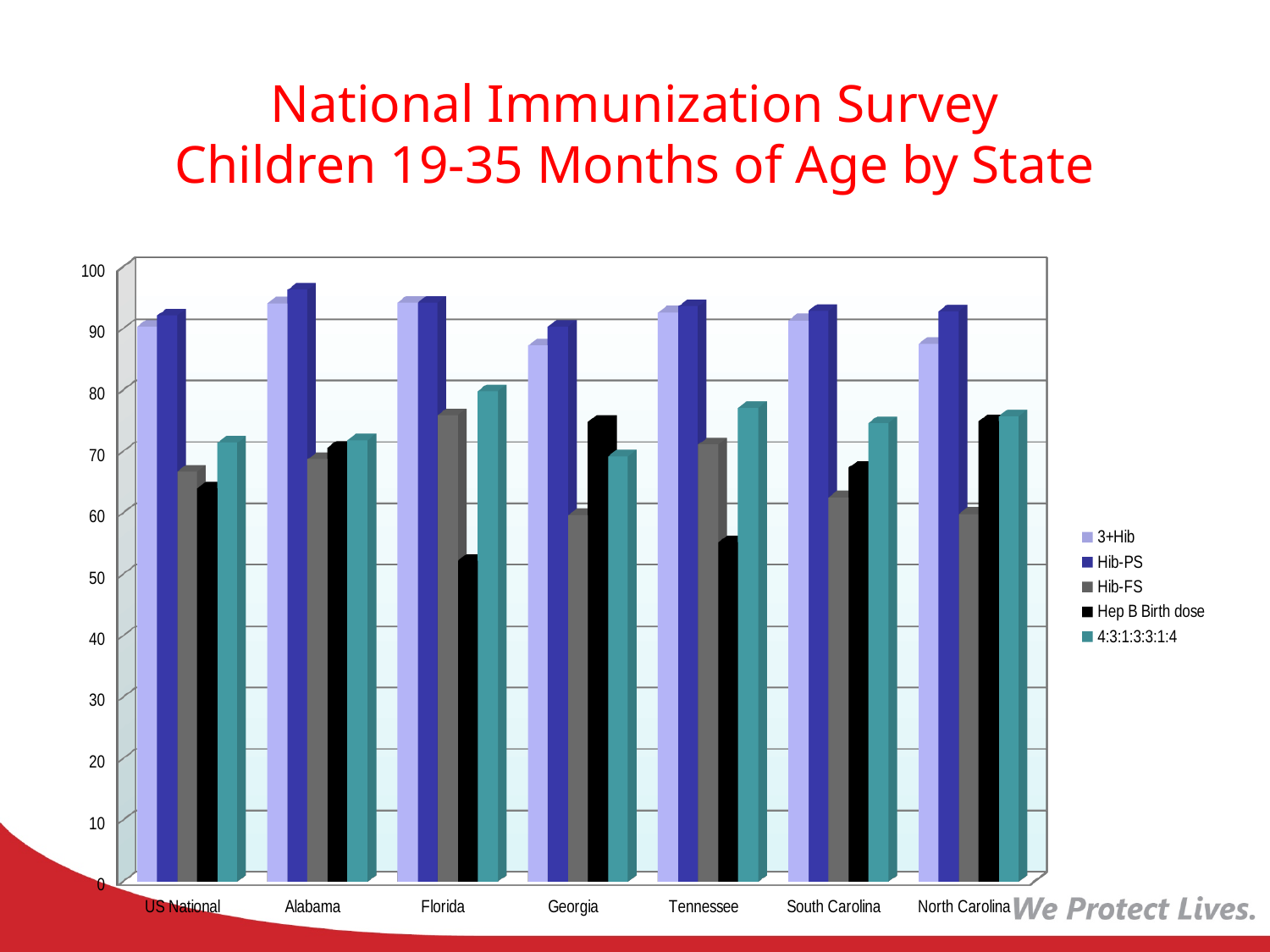
How many states or categories are shown along the x axis? 7 What kind of chart is shown on the slide? bar chart Is the Hib-PS value for Alabama greater or less than 90? greater What is the title of the slide containing the chart? National Immunization Survey Children 19-35 Months of Age by State Is the Hep B Birth dose value for Florida greater or less than 60? less Is the Hep B Birth dose value for Georgia greater or less than 70? greater How many series does the legend list? 5 For Florida, which is larger, the Hib-FS value or the Hep B Birth dose value? Hib-FS Which state has the highest Hib-PS value? Alabama Which has the larger Hep B Birth dose value, Florida or Georgia? Georgia